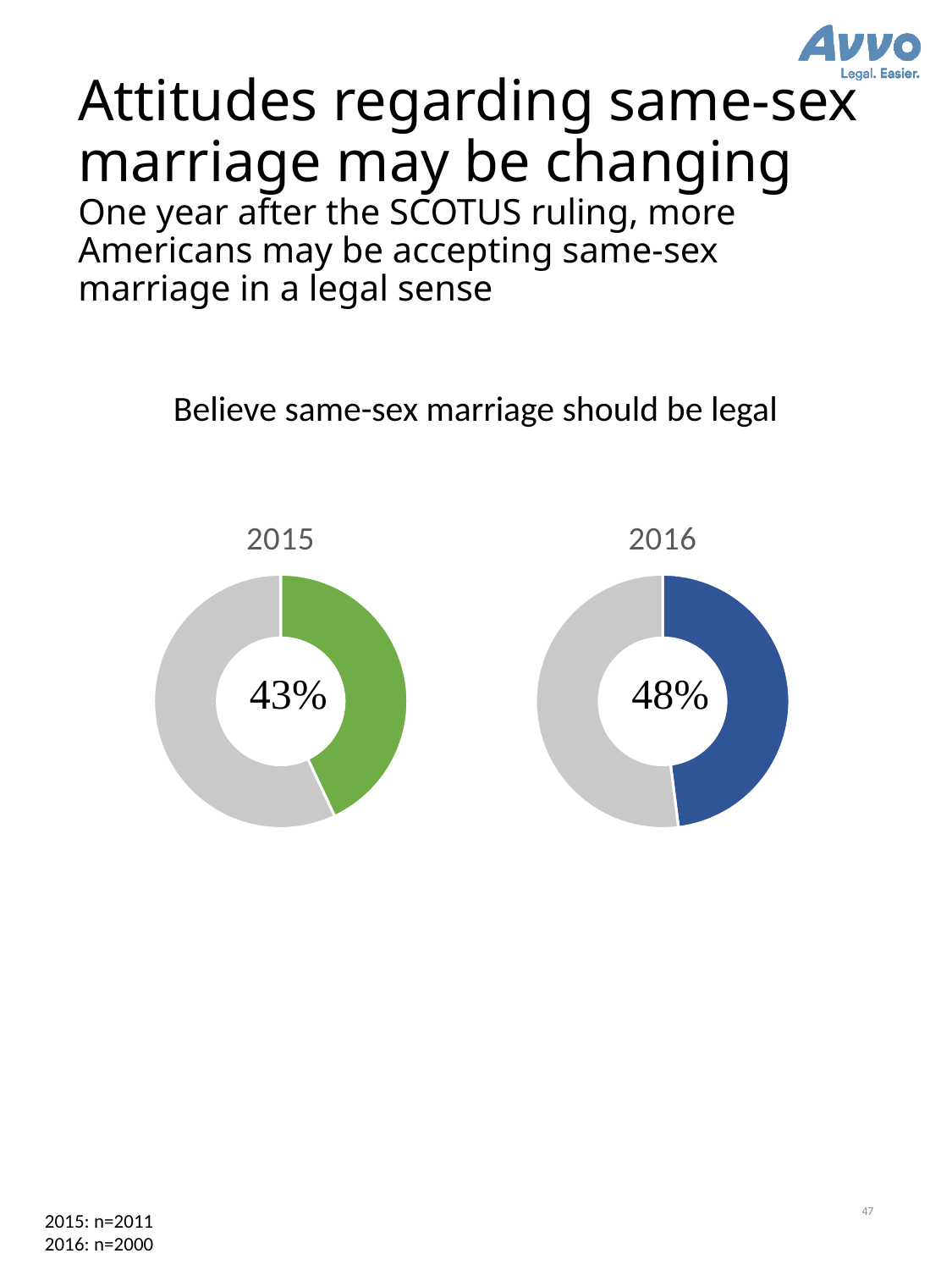
What kind of chart is used to show the 2015 and 2016 values? Donut chart Did the share believing same-sex marriage should be legal rise or fall from 2015 to 2016? Rise By how many percentage points did the share believing same-sex marriage should be legal change from the 2015 chart to the 2016 chart? 5 percentage points In the 2016 chart, is the share believing same-sex marriage should be legal greater or less than 40%? greater In the 2016 donut chart, what percentage believe same-sex marriage should be legal? 48% How many donut charts are shown on the slide? 2 In the 2015 donut chart, what percentage believe same-sex marriage should be legal? 43% What colour is the highlighted segment in the 2016 donut chart? Blue What is the title above the two donut charts? Believe same-sex marriage should be legal Comparing the 2015 and 2016 charts, which year shows the higher share believing same-sex marriage should be legal? 2016 Comparing the 2015 and 2016 charts, which year shows the lower share believing same-sex marriage should be legal? 2015 In the 2015 chart, is the share believing same-sex marriage should be legal greater or less than 50%? less